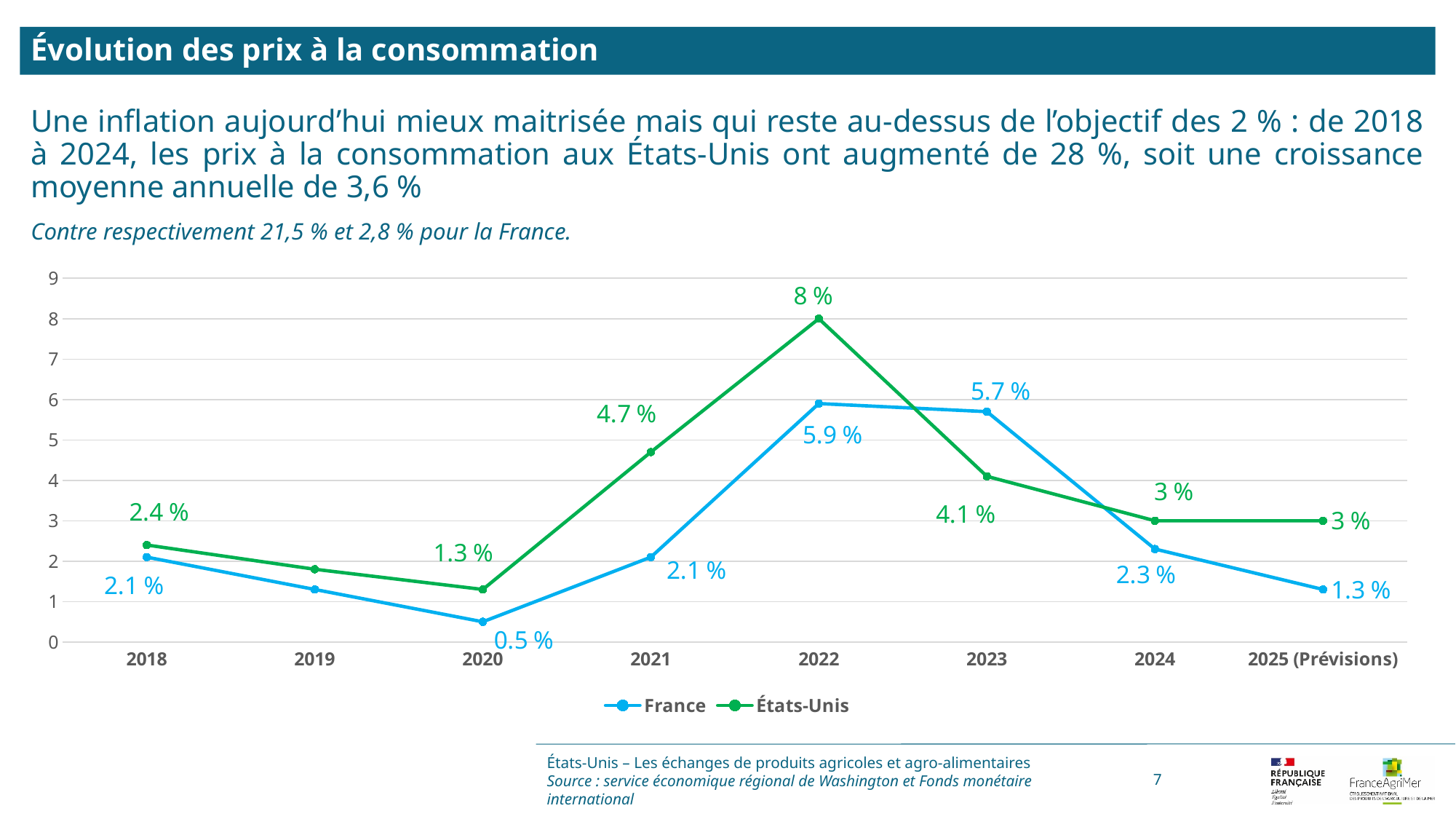
What is the difference between the États-Unis and France values in 2022? 2.1 % What kind of chart is shown on the slide? line chart Does the France series rise or fall from 2022 to 2025 (Prévisions)? fall Is the value for France in 2019 greater or less than 2? less What is the value for États-Unis in 2022? 8 % In which year does the France series reach its lowest value? 2020 What is the value for France in 2025 (Prévisions)? 1.3 % In 2023, which series has the larger value, France or États-Unis? France In which year does the États-Unis series reach its highest value? 2022 How many years are shown on the x axis? 8 What is the value for France in 2020? 0.5 % How many series does the legend list? 2